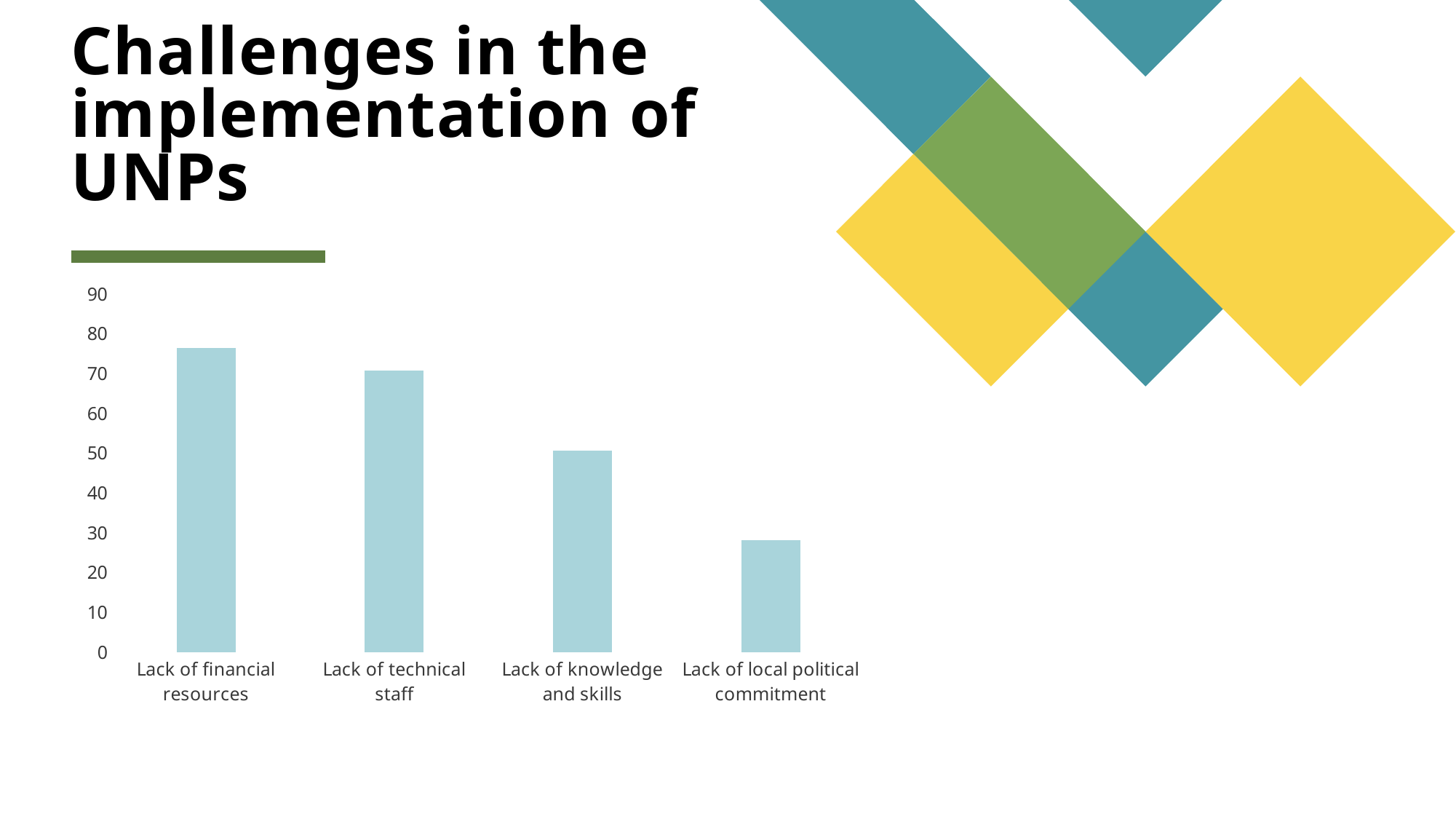
What kind of chart is shown on the slide? bar chart Which category has the lowest bar? Lack of local political commitment What is the title of the slide containing the chart? Challenges in the implementation of UNPs Is the value for Lack of knowledge and skills greater or less than 60? less Is the value for Lack of financial resources greater or less than 70? greater How many categories are plotted in the chart? 4 Is the value for Lack of financial resources greater or less than 80? less Which is larger, the value for Lack of technical staff or the value for Lack of knowledge and skills? Lack of technical staff Which category has the highest bar? Lack of financial resources Do the bar values rise or fall from left to right across the categories? fall